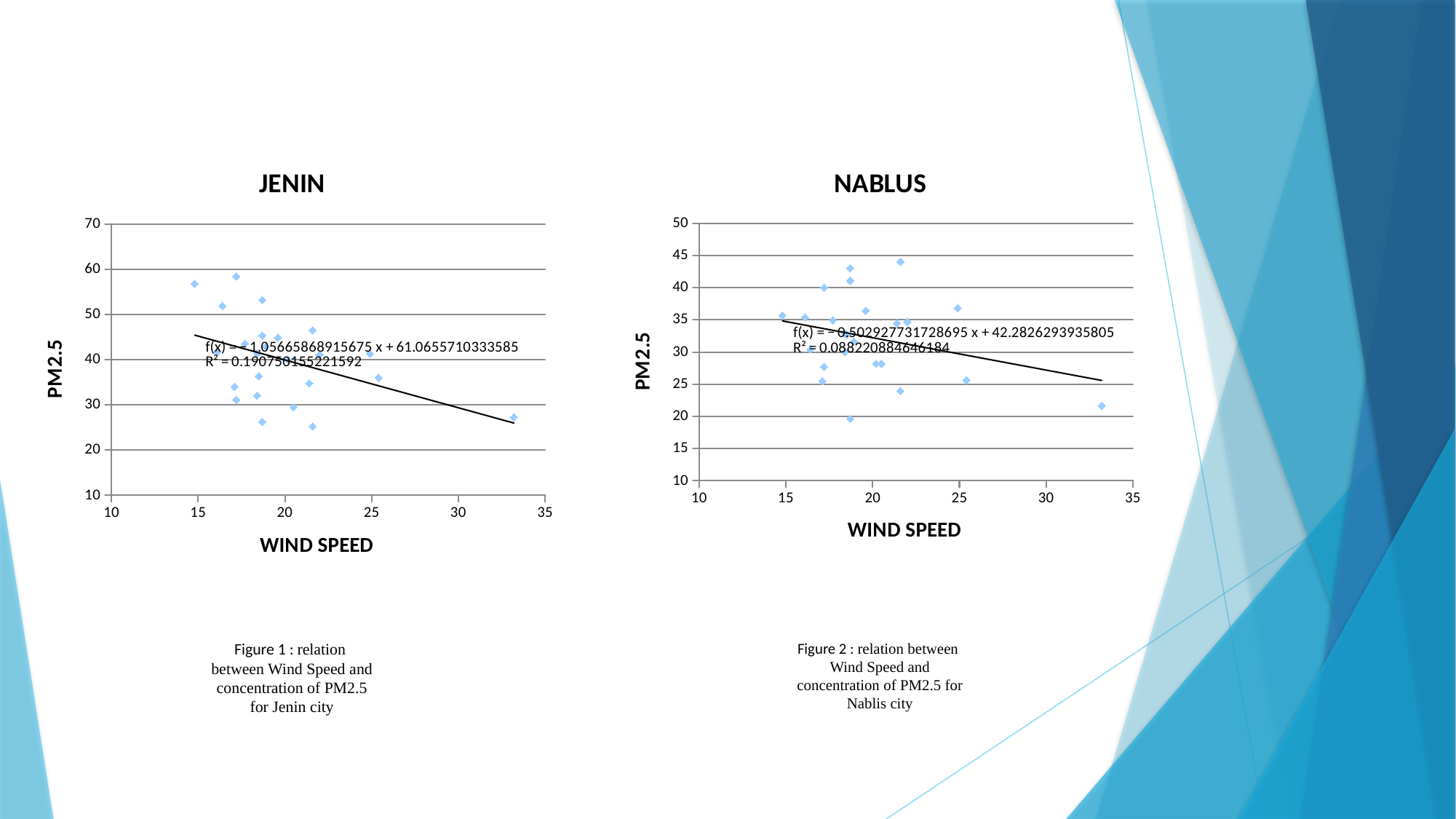
What is the label on the horizontal axis of the JENIN chart? WIND SPEED In the JENIN chart, is the PM2.5 value of the point with the highest wind speed (around 33) greater or less than 30? less In the NABLUS chart, is the PM2.5 value of the highest point greater or less than 40? greater What is the R² value printed on the NABLUS chart? 0.088220884646184 What kind of chart is the JENIN chart? scatter chart What kind of chart is the NABLUS chart? scatter chart In the JENIN chart, does the fitted trendline rise or fall as wind speed increases? fall What is the trendline equation printed on the JENIN chart? f(x) = − 1.05665868915675 x + 61.0655710333585 What is the R² value printed on the JENIN chart? 0.190750155221592 In the NABLUS chart, does the fitted trendline rise or fall as wind speed increases? fall What is the trendline equation printed on the NABLUS chart? f(x) = − 0.502927731728695 x + 42.2826293935805 In the NABLUS chart, is the PM2.5 value of the point with the highest wind speed (around 33) greater or less than 25? less